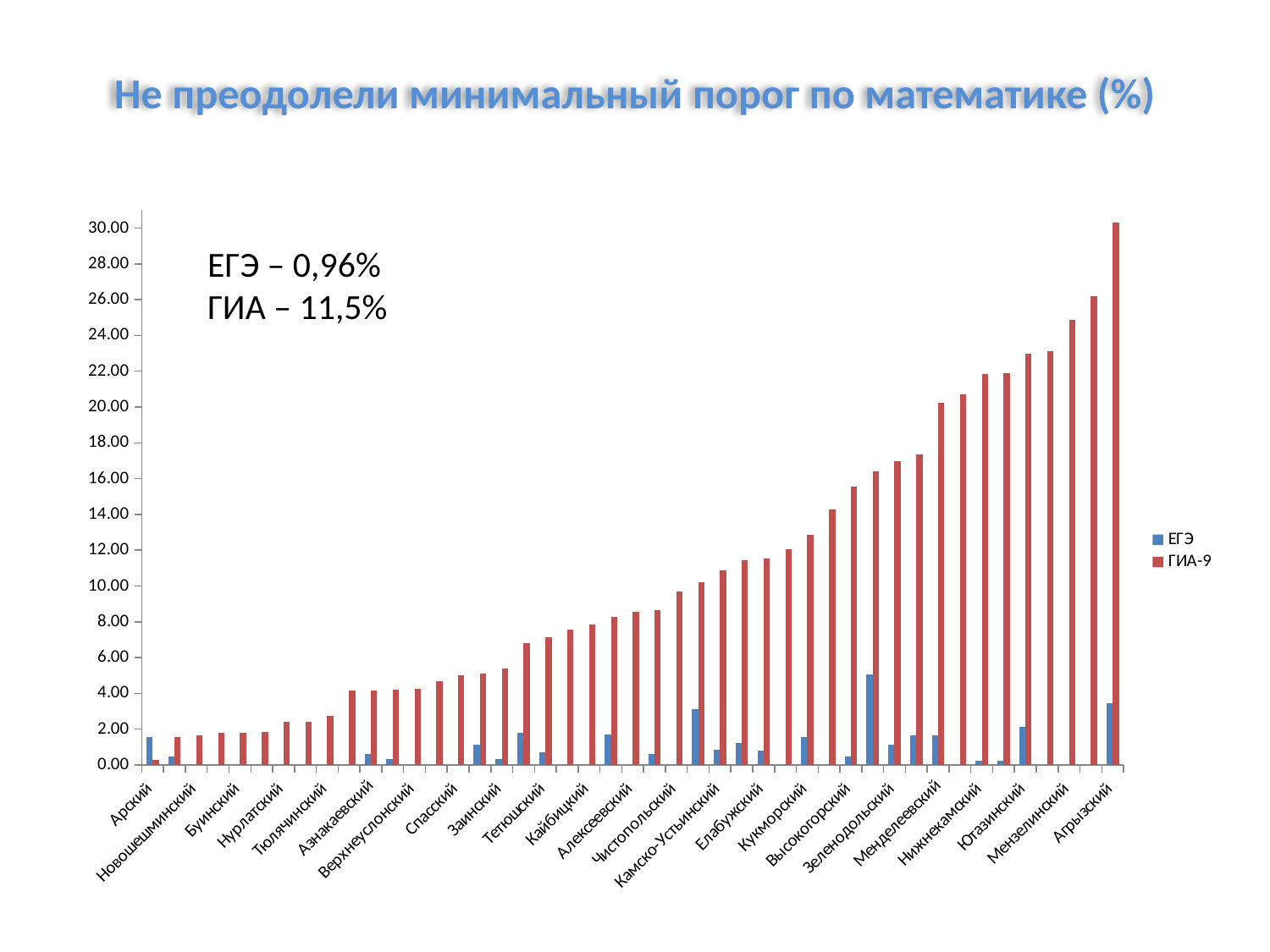
How many series does the legend list? 2 Do the ГИА-9 values rise or fall from left to right along the x axis? rise Is the tallest ЕГЭ bar greater or less than 4.00? greater Is the ГИА-9 value for Агрызский greater or less than 28.00? greater What kind of chart is shown on the slide? bar chart For Агрызский, which is larger: the ЕГЭ value or the ГИА-9 value? ГИА-9 Which is larger: the ГИА-9 value for Агрызский or the ГИА-9 value for Арский? Агрызский Which series is shown in red in the legend? ГИА-9 Is the ГИА-9 value for Арский greater or less than 2.00? less Which category has the highest ГИА-9 value? Агрызский What is the title of the chart? Не преодолели минимальный порог по математике (%) Which category has the lowest ГИА-9 value? Арский